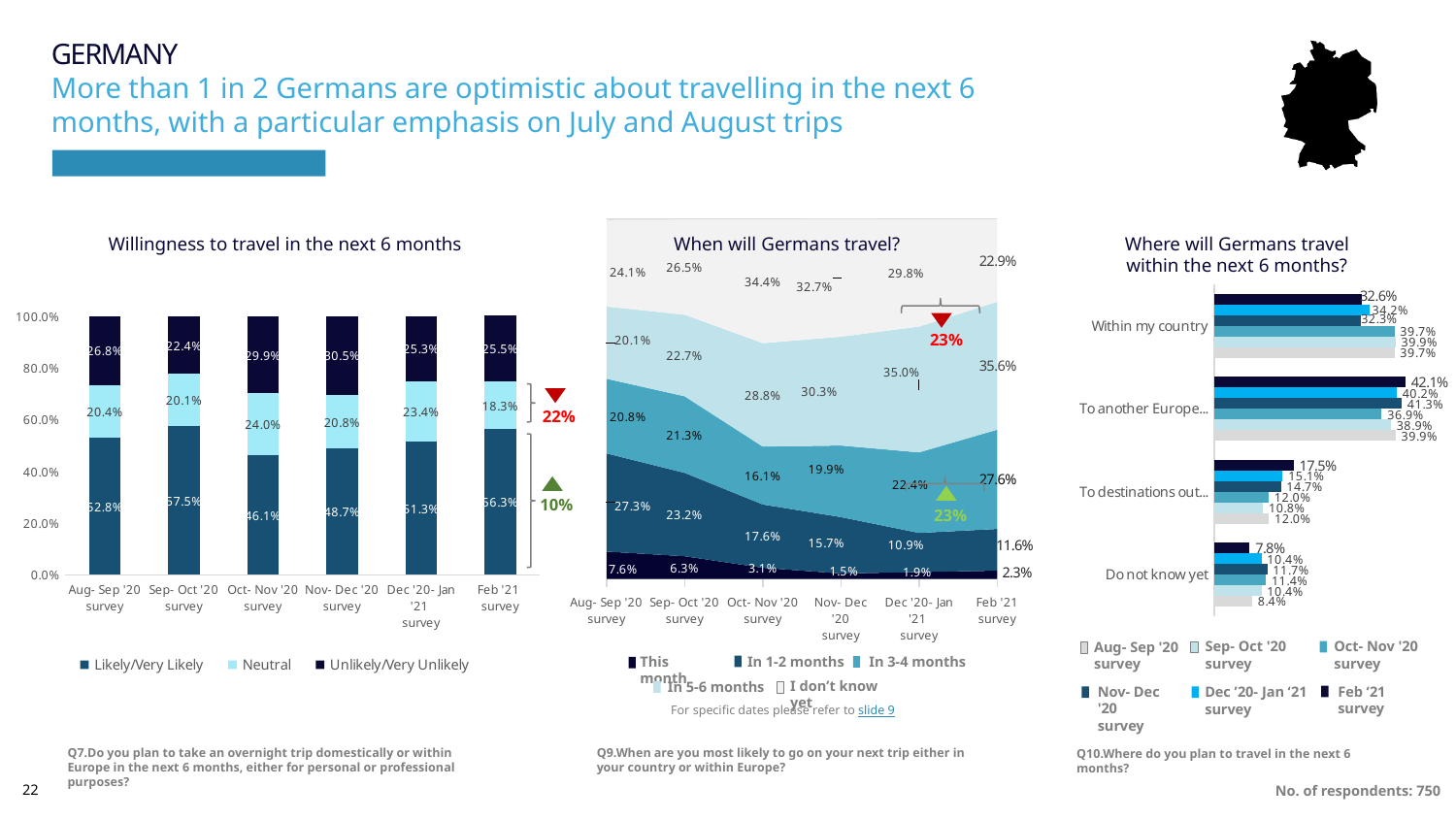
In the 'Where will Germans travel within the next 6 months?' chart, what is the difference between the Aug- Sep '20 survey and Feb '21 survey values for 'Do not know yet'? 0.6% In the 'When will Germans travel?' chart, what is the 'In 5-6 months' value for the Feb '21 survey? 35.6% What kind of chart is 'Willingness to travel in the next 6 months'? Stacked bar chart In the 'Willingness to travel in the next 6 months' chart, what is the Likely/Very Likely value for the Feb '21 survey? 56.3% In the 'Willingness to travel in the next 6 months' chart, what is the difference between the Neutral values for the Oct- Nov '20 survey and the Feb '21 survey? 5.7% In the 'Willingness to travel in the next 6 months' chart, how many series does the legend list? 3 In the 'When will Germans travel?' chart, which is larger for the Dec '20- Jan '21 survey: 'In 3-4 months' or 'In 1-2 months'? In 3-4 months In the 'When will Germans travel?' chart, how many survey periods are shown on the x axis? 6 In the 'Willingness to travel in the next 6 months' chart, which survey has the lowest Likely/Very Likely value? Oct- Nov '20 survey In the 'When will Germans travel?' chart, does the 'This month' value rise or fall from the Aug- Sep '20 survey to the Nov- Dec '20 survey? Fall In the 'Willingness to travel in the next 6 months' chart, which survey has the highest Likely/Very Likely value? Sep- Oct '20 survey In the 'Where will Germans travel within the next 6 months?' chart, what is the Aug- Sep '20 survey value for 'To another Europe...'? 39.9%